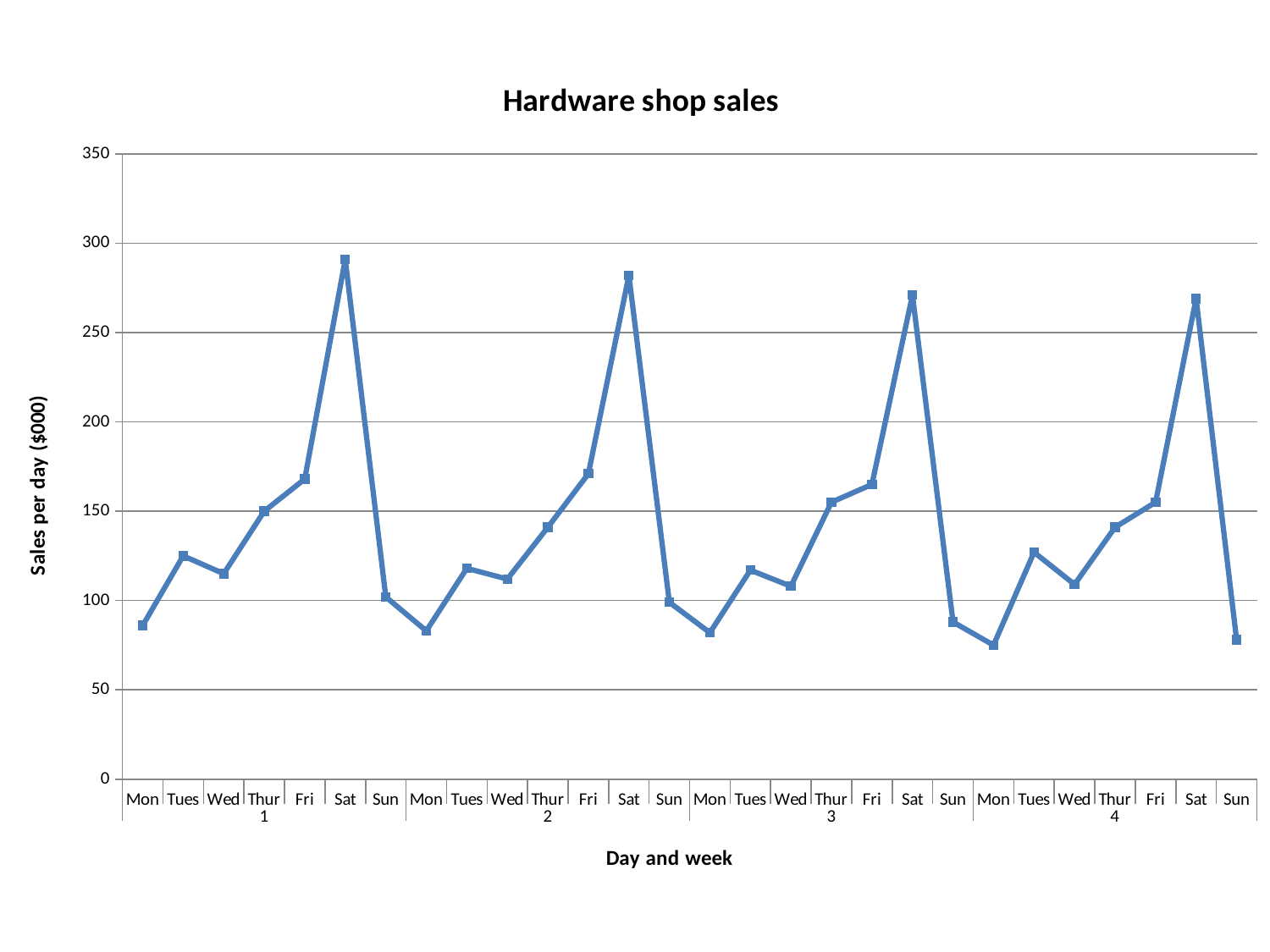
Is the value for Fri in week 2 greater or less than 150? greater Is the value for Sun in week 3 greater or less than 100? less On which day and week do sales reach their highest value? Sat, week 1 Is the value for Mon in week 1 greater or less than 100? less What kind of chart is shown on the slide? line chart Which is larger, the value for Sat in week 1 or the value for Sat in week 4? Sat in week 1 How many data points are plotted on the chart? 28 Do sales rise or fall from Sat to Sun in week 1? fall What is the title of the chart? Hardware shop sales What is the label on the vertical axis of the chart? Sales per day ($000)